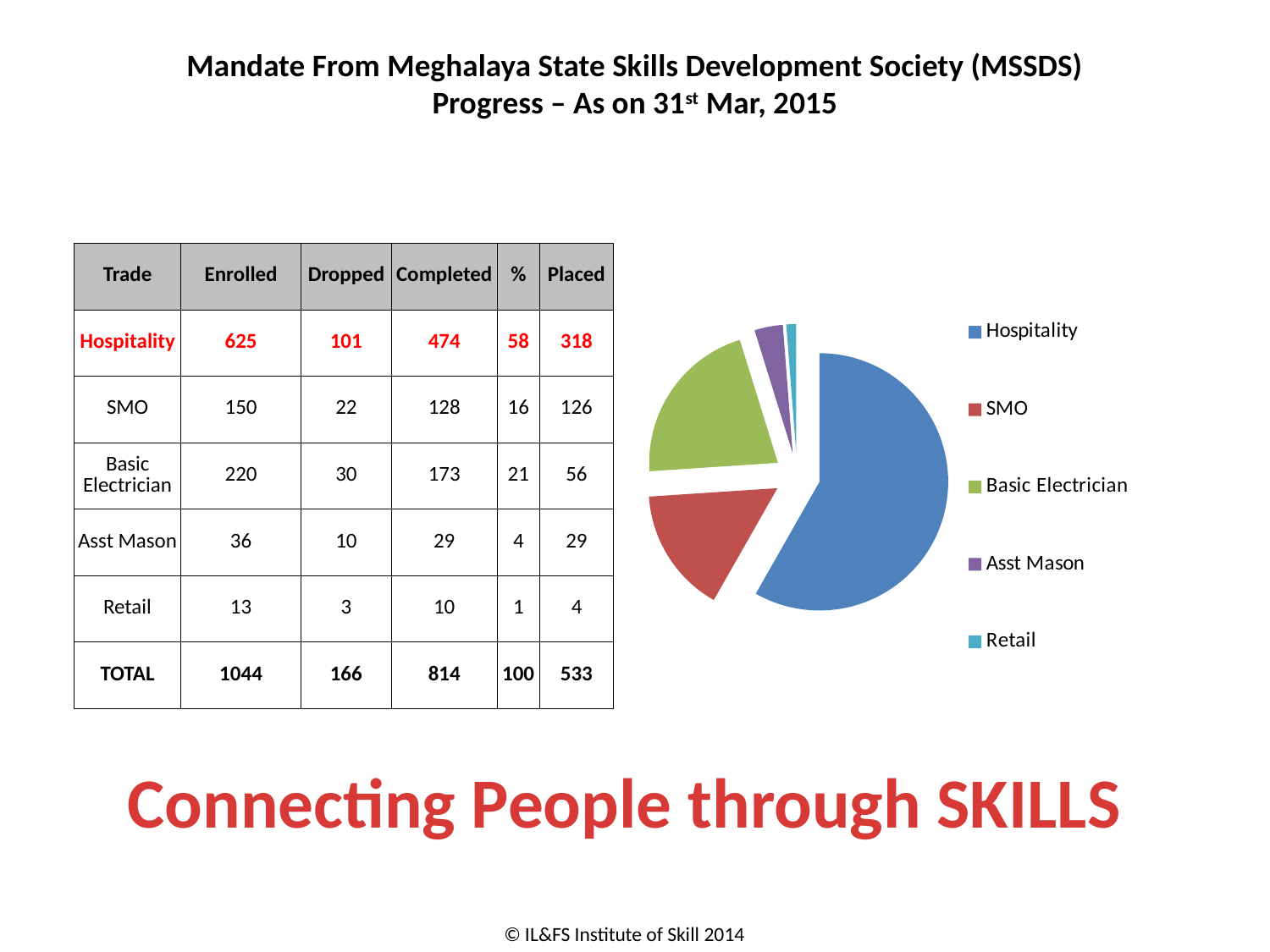
In the pie chart, which slice is larger, Basic Electrician or Asst Mason? Basic Electrician Which category has the smallest slice in the pie chart? Retail Which category has the largest slice in the pie chart? Hospitality In the pie chart, which slice is larger, Asst Mason or Retail? Asst Mason Does the Hospitality slice take up more or less than half of the pie chart? more In the pie chart, which slice is larger, SMO or Basic Electrician? Basic Electrician How many slices does the pie chart have? 5 Which category is shown in red in the pie chart? SMO Which category is shown in green in the pie chart? Basic Electrician What kind of chart is shown on the slide? pie chart